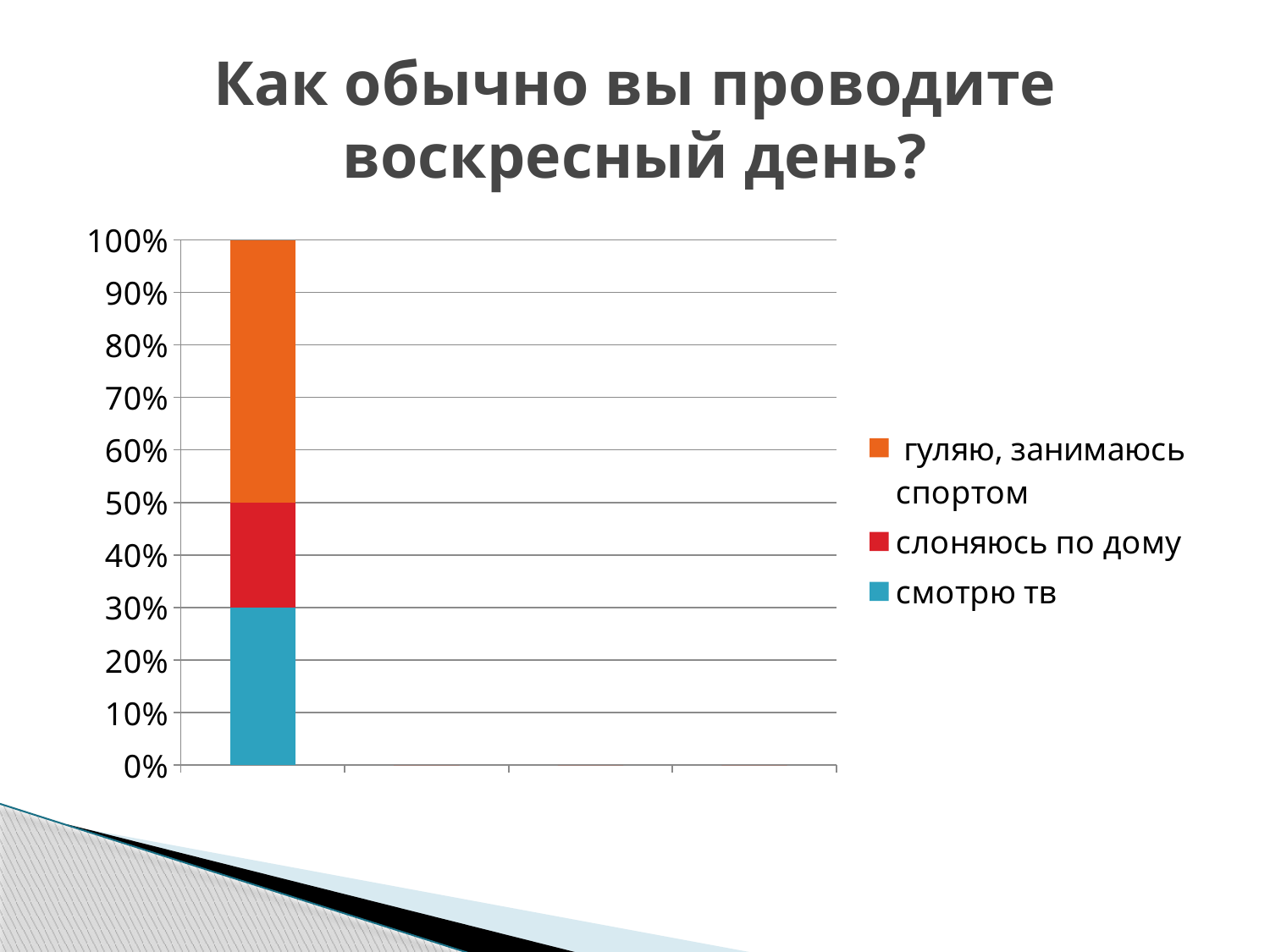
What kind of chart is shown on the slide? stacked bar chart Is the share for "смотрю тв" greater or less than 40%? less Which colour represents the series "смотрю тв" in the legend? blue What share of the bar does the "смотрю тв" segment occupy? 30% Is the segment for "гуляю, занимаюсь спортом" larger or smaller than the segment for "слоняюсь по дому"? larger How many series does the legend list? 3 What is the title of the chart on the slide? Как обычно вы проводите воскресный день? Is the share for "гуляю, занимаюсь спортом" greater or less than 40%? greater What is the total height of the stacked bar? 100% Which series has the smallest segment in the stacked bar? слоняюсь по дому Which series has the largest segment in the stacked bar? гуляю, занимаюсь спортом At what percentage does the top of the "слоняюсь по дому" segment end on the axis? 50%